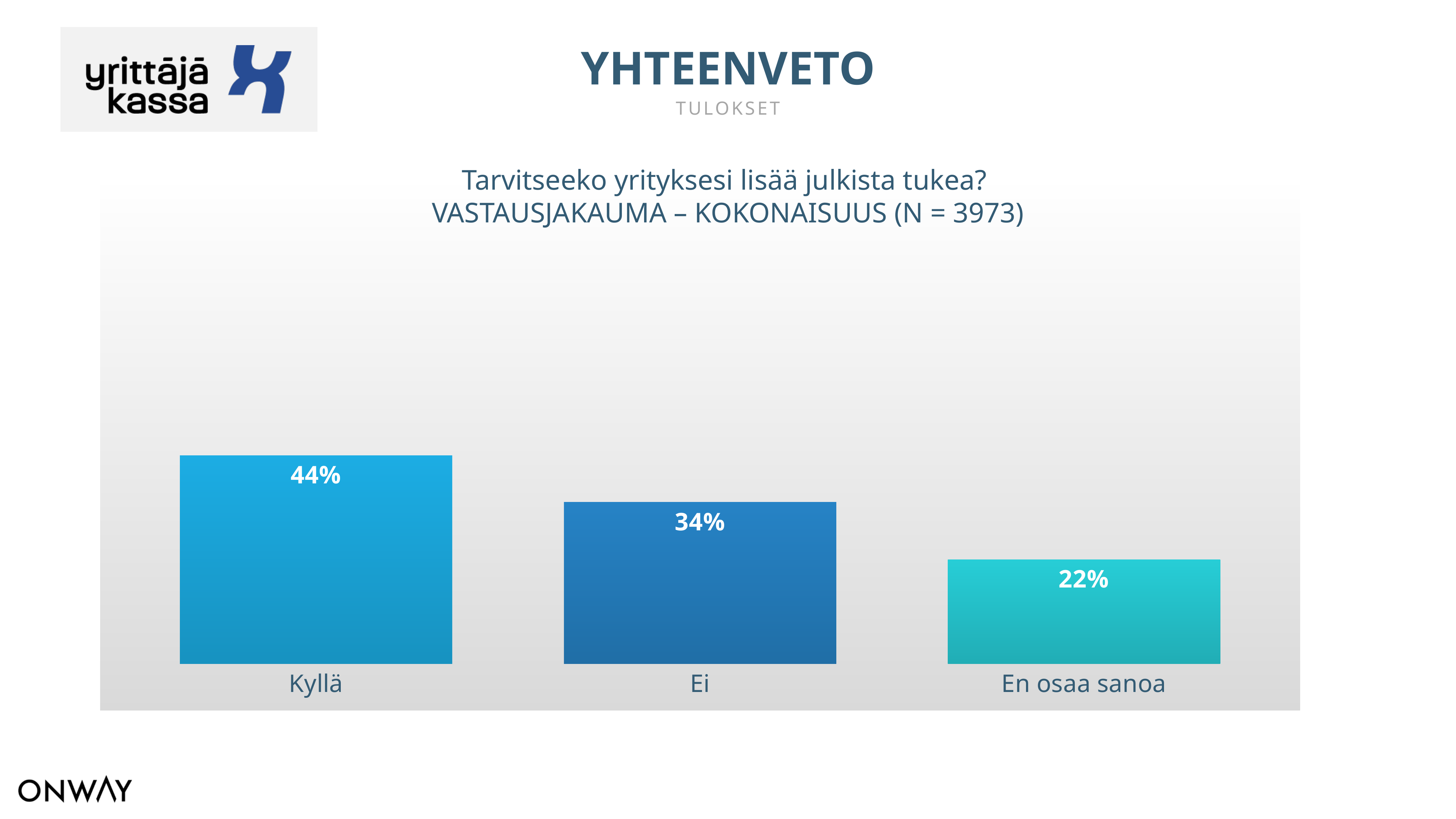
What kind of chart is shown on the slide? Bar chart What is the difference between the values for Ei and En osaa sanoa? 12% Which category has the highest value? Kyllä What is the value for Ei? 34% Which is larger, the value for Ei or the value for En osaa sanoa? Ei What is the value for Kyllä? 44% What is the difference between the values for Kyllä and Ei? 10% What is the sample size (N) stated in the chart title? 3973 How many categories are shown in the chart? 3 Which category has the lowest value? En osaa sanoa Do the values rise or fall from left to right across the categories? Fall What is the value for En osaa sanoa? 22%